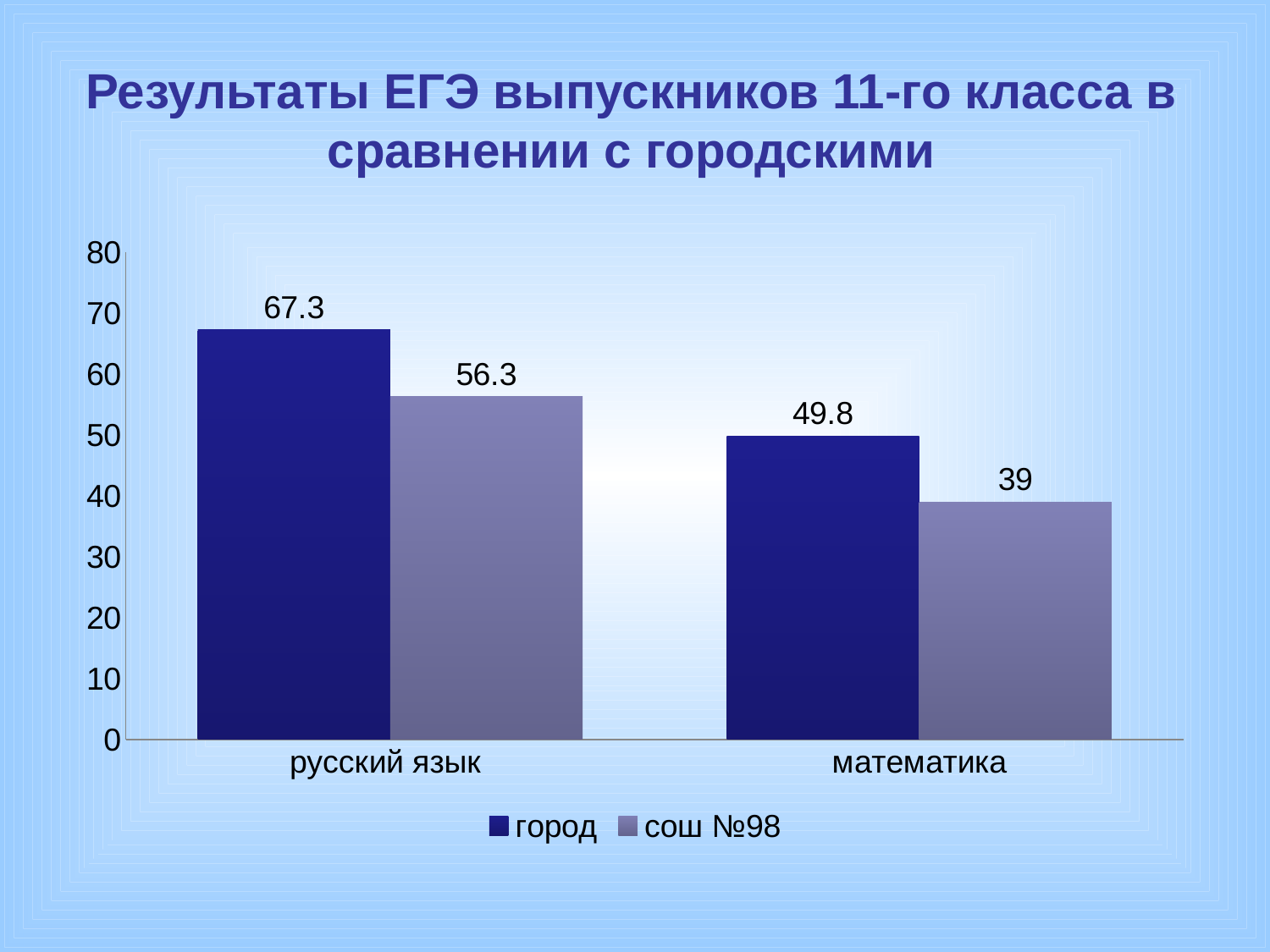
How many series does the legend list? 2 What kind of chart is shown on the slide? bar chart What is the value for город in математика? 49.8 Which bar has the lowest value on the chart? сош №98, математика Which is larger in математика: город or сош №98? город Which bar has the highest value on the chart? город, русский язык What is the value for город in русский язык? 67.3 How many categories are shown on the x axis? 2 What is the difference between город and сош №98 in математика? 10.8 What is the difference between город and сош №98 in русский язык? 11 What is the value for сош №98 in русский язык? 56.3 What is the value for сош №98 in математика? 39